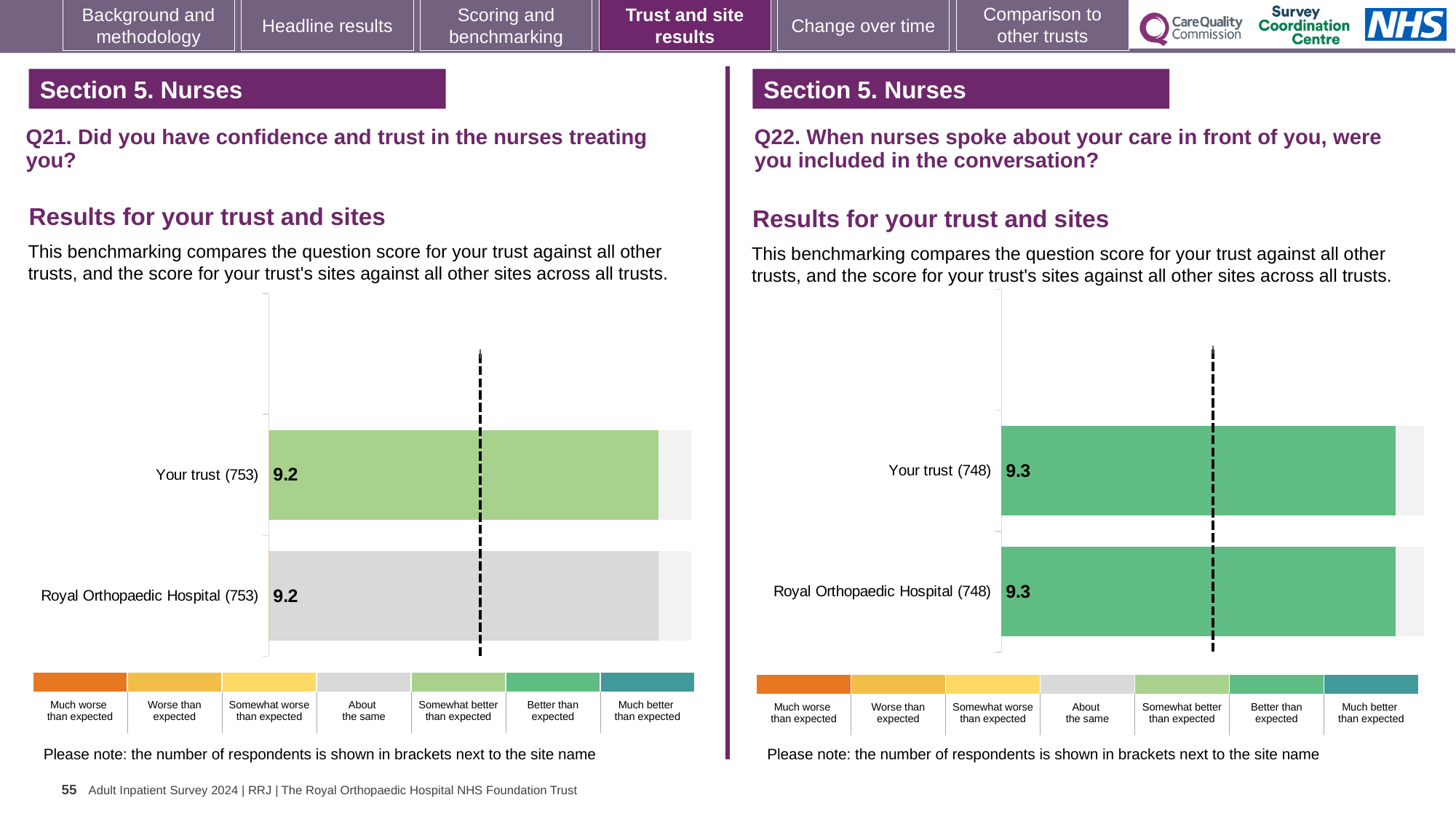
On the Q21 chart (left), how many respondents are shown in brackets for Your trust? 753 On the Q21 chart (left), which benchmark category does the colour of the Royal Orthopaedic Hospital bar correspond to? About the same On the Q21 chart (left), what is the score for Your trust (753)? 9.2 On the Q22 chart (right), which benchmark category does the colour of the Your trust bar correspond to? Better than expected On the Q21 chart (left), what is the difference between the score for Your trust and the score for Royal Orthopaedic Hospital? 0.0 On the Q22 chart (right), what is the score for Royal Orthopaedic Hospital (748)? 9.3 On the Q22 chart (right), what is the difference between the score for Your trust and the score for Royal Orthopaedic Hospital? 0.0 What kind of chart is used on the Q22 chart (right)? Bar chart On the Q21 chart (left), what is the score for Royal Orthopaedic Hospital (753)? 9.2 How many bars are plotted on the Q21 chart (left)? 2 How many bars are plotted on the Q22 chart (right)? 2 On the Q22 chart (right), what is the score for Your trust (748)? 9.3